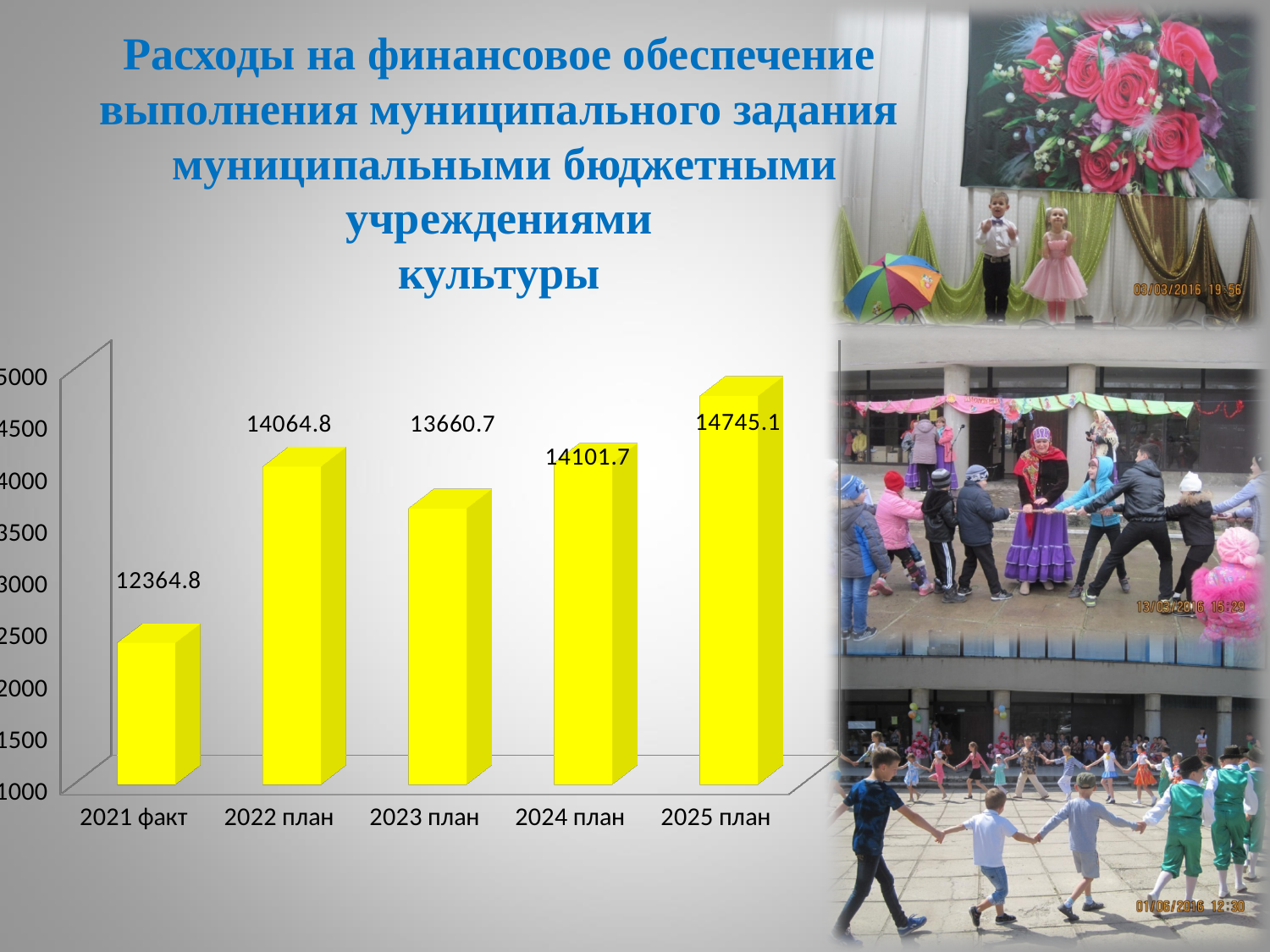
Which category has the lowest value? 2021 факт How many categories are shown on the x axis? 5 What is the value for 2021 факт? 12364.8 What is the value for 2025 план? 14745.1 What kind of chart is shown on the slide? bar chart What is the value for 2023 план? 13660.7 What is the difference between the values for 2022 план and 2023 план? 404.1 What is the difference between the values for 2025 план and 2021 факт? 2380.3 Does the value rise or fall from 2022 план to 2023 план? fall Which category has the highest value? 2025 план What is the value for 2024 план? 14101.7 Which is larger, the value for 2022 план or the value for 2023 план? 2022 план